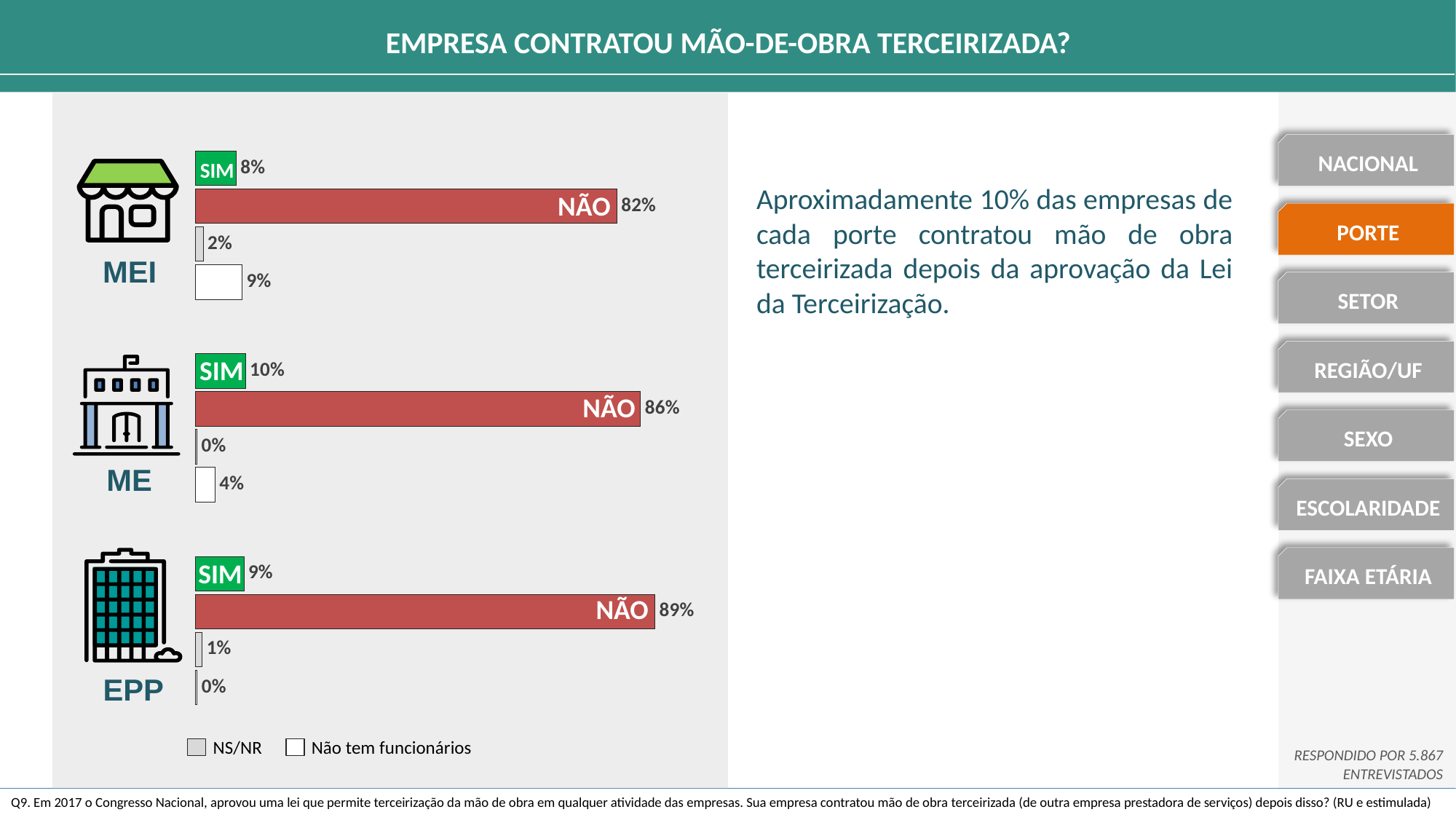
How many bars are shown in the MEI chart? 4 What colour are the NÃO bars in the charts? Red In the MEI chart, what is the value for Não tem funcionários? 9% Which is larger: the SIM value for ME or the SIM value for EPP? ME In the ME chart, which category has the lowest value? NS/NR Across the three charts, which company size (MEI, ME or EPP) has the highest NÃO percentage? EPP In the EPP chart, what is the difference between the NÃO and SIM values? 80% What is the difference between the NÃO percentages for EPP and MEI? 7% In the MEI chart, what percentage answered NÃO? 82% In the ME chart, what percentage answered SIM? 10% What type of chart is used to show the MEI, ME and EPP results? Bar chart In the EPP chart, what is the value for NS/NR? 1%